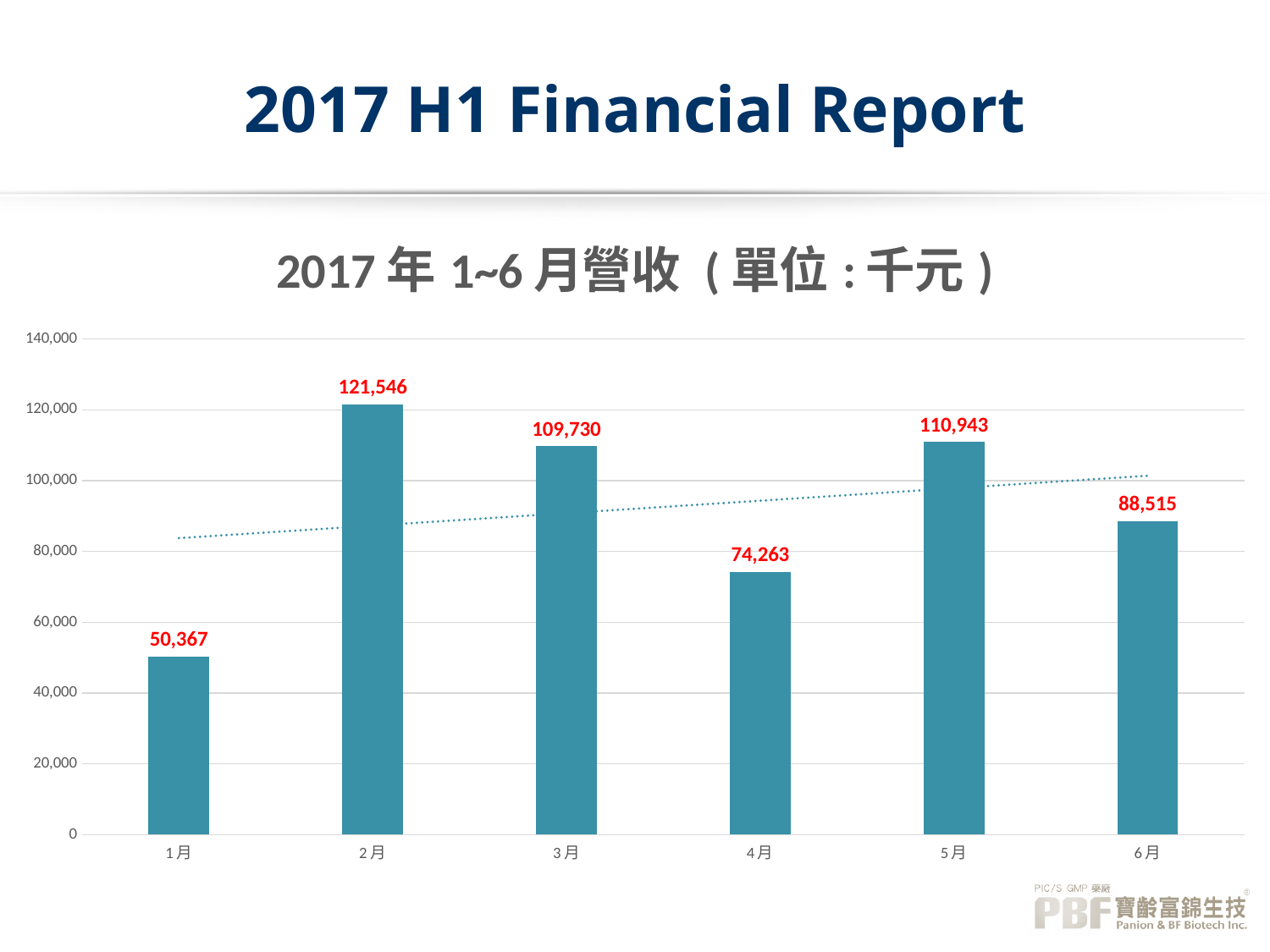
How many months are shown on the x axis? 6 Which month has the lowest revenue? 1月 What is the revenue value for 1月? 50,367 Is the revenue for 6月 greater or less than 100,000? less What kind of chart is shown on the slide? bar chart What is the revenue value for 6月? 88,515 What is the revenue value for 4月? 74,263 Which month has the highest revenue? 2月 What is the difference between the revenue for 2月 and 1月? 71,179 What unit is stated in the chart title? 千元 Which is larger, the revenue for 3月 or 5月? 5月 What is the difference between the revenue for 5月 and 4月? 36,680